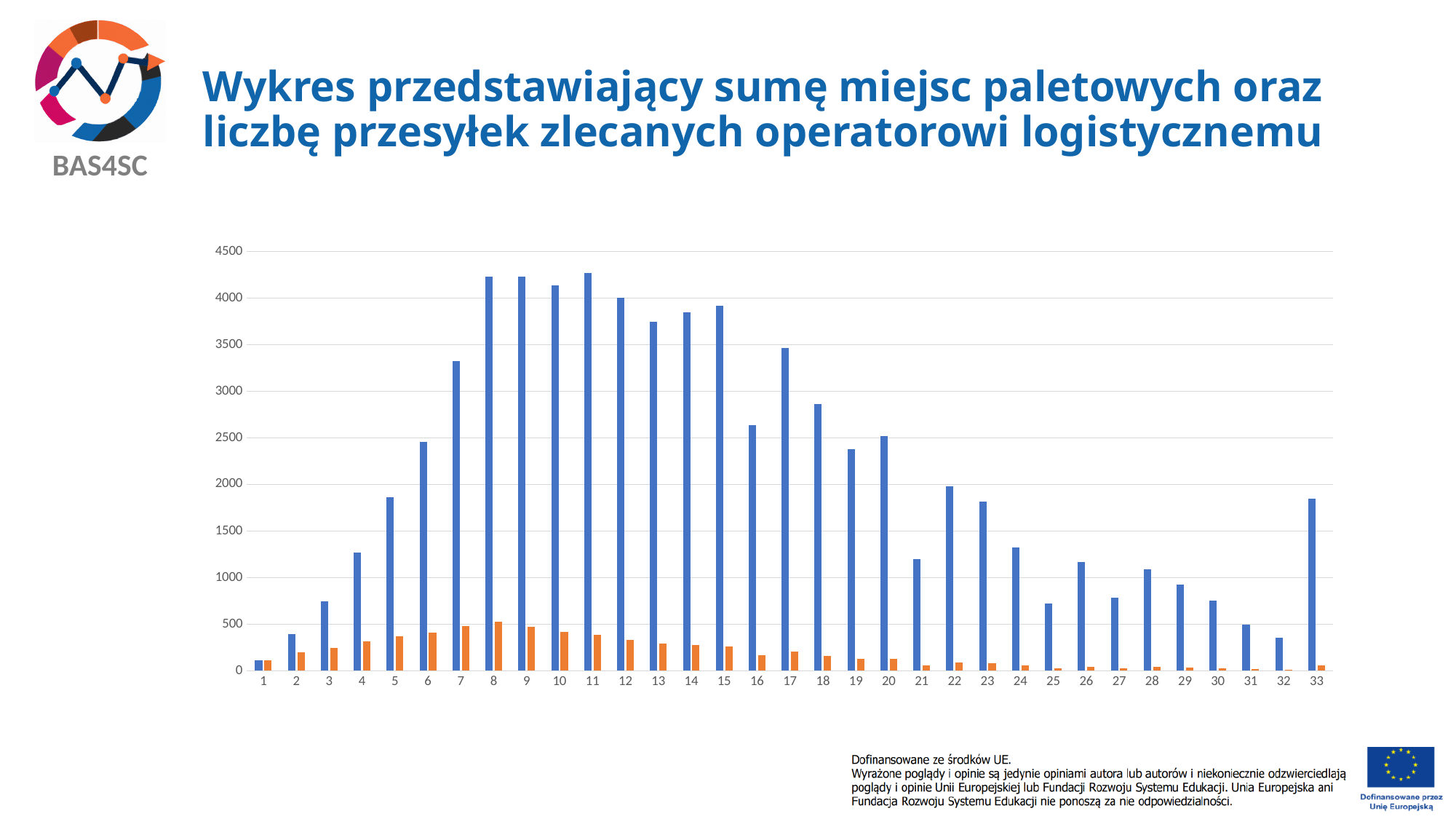
Is the value of the blue bar for category 16 greater or less than 2500? greater Which blue bar is taller, category 17 or category 18? 17 Do the blue bars generally rise or fall from category 1 to category 11? rise Is the value of the blue bar for category 11 greater or less than 4000? greater Is the value of the blue bar for category 33 greater or less than 1500? greater What kind of chart is shown on the slide? bar chart Which category has the lowest blue bar? 1 How many differently coloured bar series are plotted in the chart? 2 How many categories are shown along the x axis of the chart? 33 Which category has the highest orange bar? 8